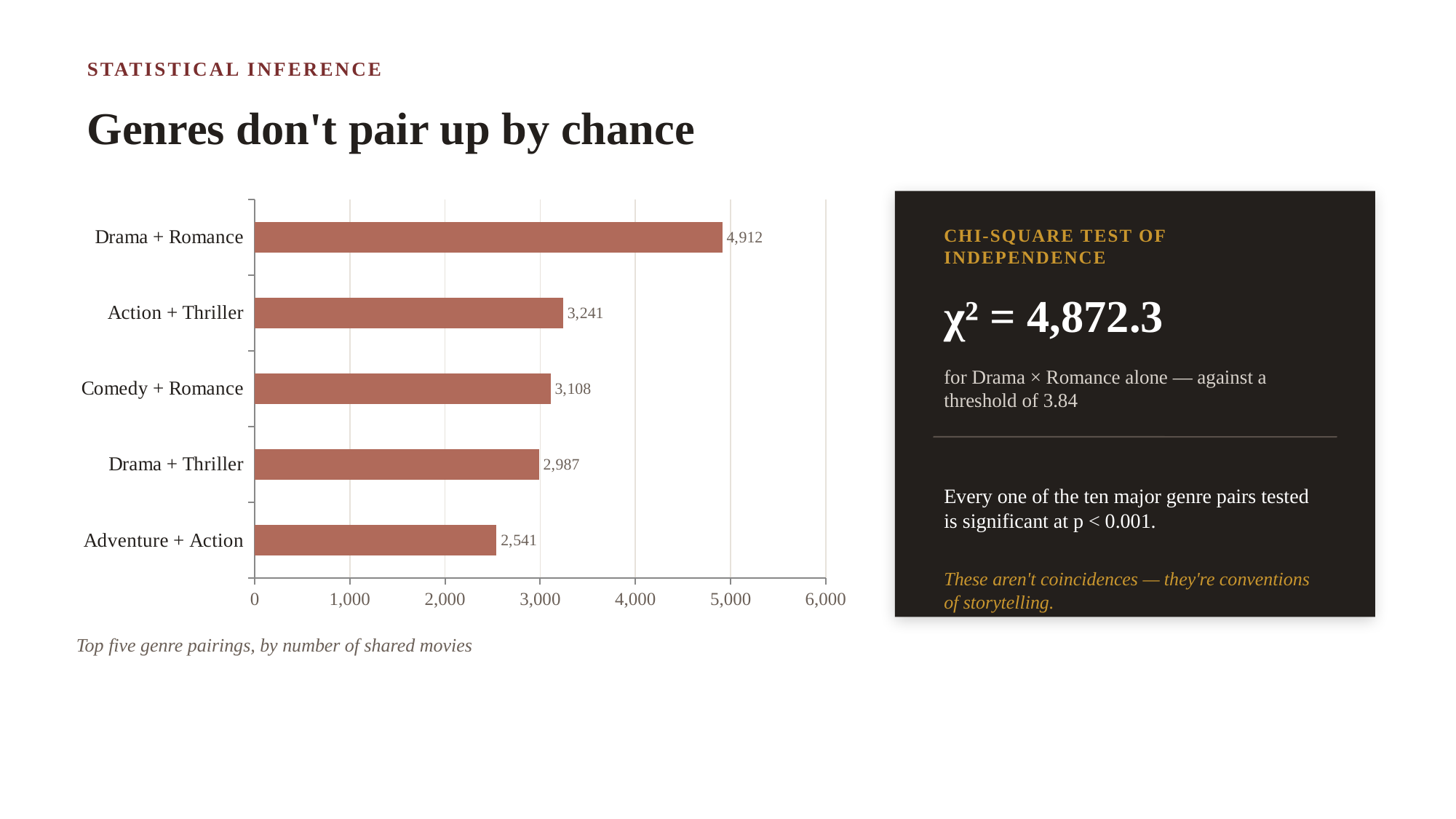
What kind of chart is shown on the slide? Bar chart What is the difference between the values for Drama + Thriller and Adventure + Action? 446 Is the value for Drama + Thriller greater or less than 3,000? less What is the caption below the chart? Top five genre pairings, by number of shared movies What is the difference between the values for Drama + Romance and Action + Thriller? 1,671 What is the number of shared movies for Drama + Romance? 4,912 Which genre pairing has the highest number of shared movies? Drama + Romance What is the number of shared movies for Comedy + Romance? 3,108 Which has more shared movies, Action + Thriller or Comedy + Romance? Action + Thriller Which genre pairing has the lowest number of shared movies? Adventure + Action How many genre pairings are shown in the chart? 5 What is the value shown for Adventure + Action? 2,541